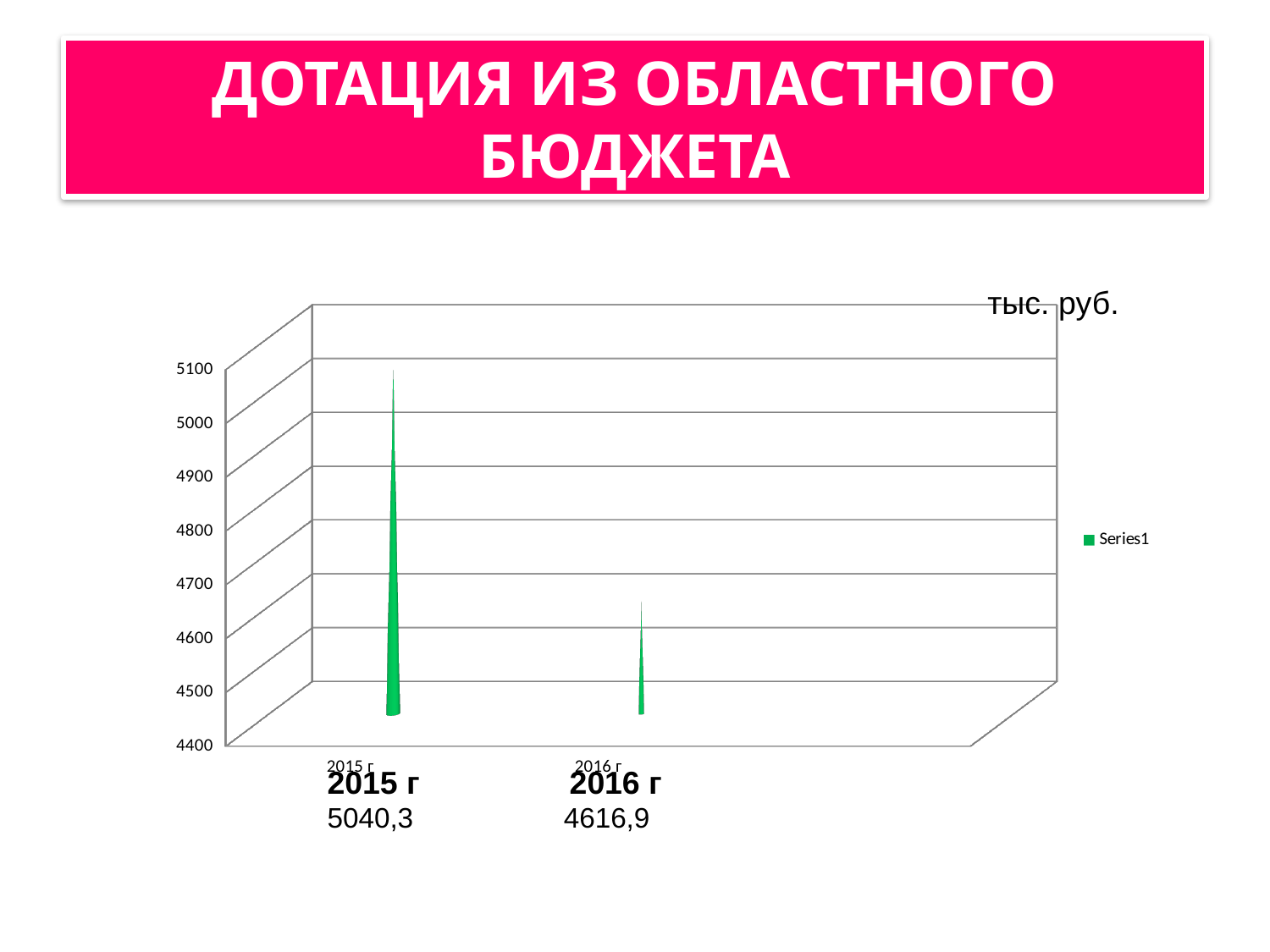
Is the value for 2015 г greater or less than 5000? greater What is the value for 2016 г? 4616,9 Which year has the lowest value? 2016 г How many categories are shown on the chart? 2 Is the value for 2016 г greater or less than 4700? less Which is larger, the value for 2015 г or for 2016 г? 2015 г What is the value for 2015 г? 5040,3 How many series does the legend list? 1 Which year has the highest value? 2015 г What is the difference between the values for 2015 г and 2016 г? 423,4 What kind of chart is shown on the slide? bar chart Do the values rise or fall from 2015 г to 2016 г? fall